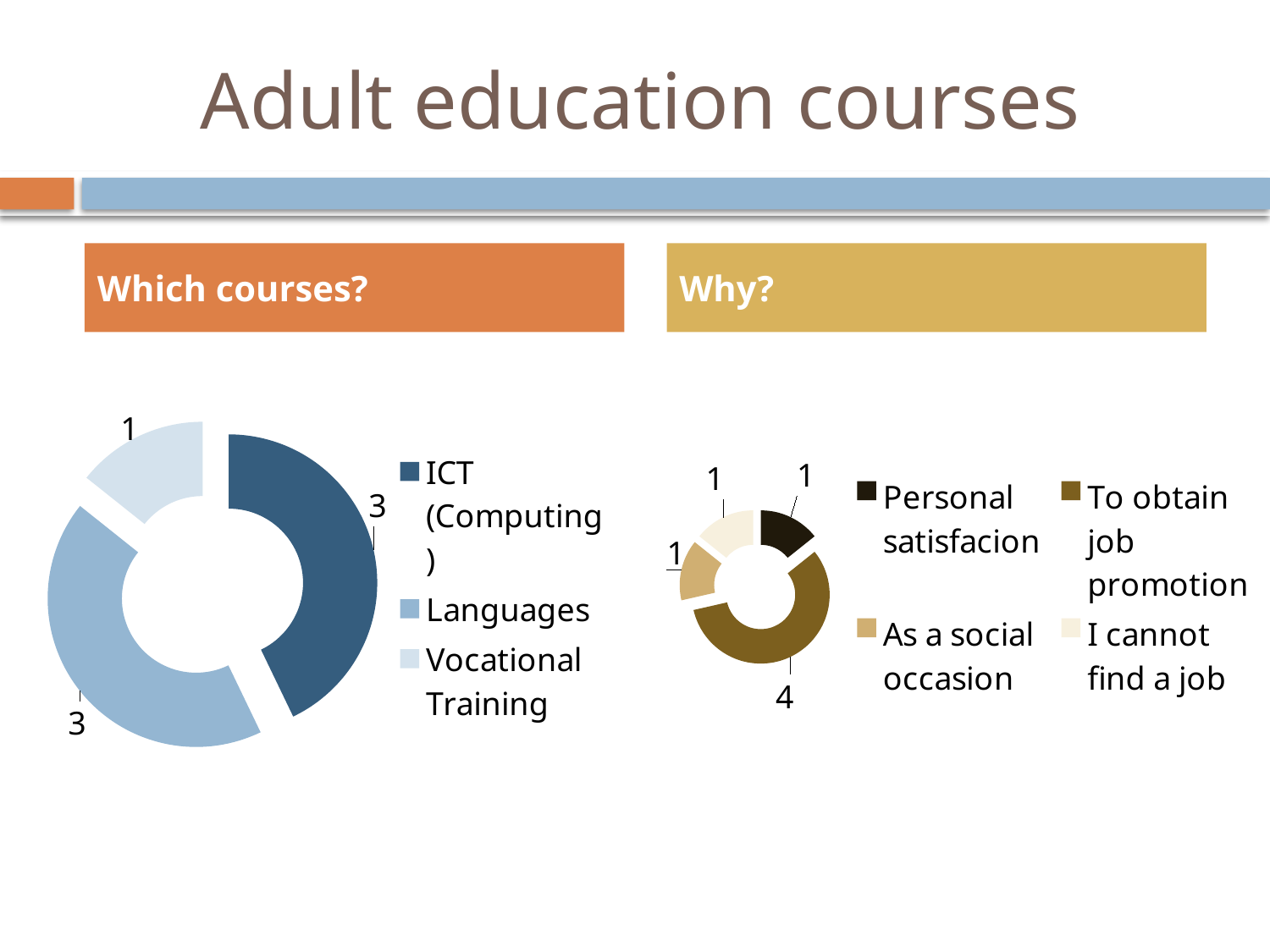
In the 'Which courses?' chart, what is the value for Vocational Training? 1 In the 'Why?' chart, what is the value for 'To obtain job promotion'? 4 In the 'Why?' chart, how many categories does the legend list? 4 In the 'Which courses?' chart, how many categories are shown? 3 In the 'Which courses?' chart, what is the difference between the values for ICT (Computing) and Vocational Training? 2 What type of chart is used for the 'Why?' data? Doughnut chart In the 'Why?' chart, what is the value for 'As a social occasion'? 1 In the 'Which courses?' chart, what is the value for Languages? 3 In the 'Why?' chart, what is the difference between the values for 'To obtain job promotion' and 'Personal satisfacion'? 3 In the 'Which courses?' chart, what is the value for ICT (Computing)? 3 In the 'Why?' chart, which category has the highest value? To obtain job promotion In the 'Which courses?' chart, which category has the lowest value? Vocational Training